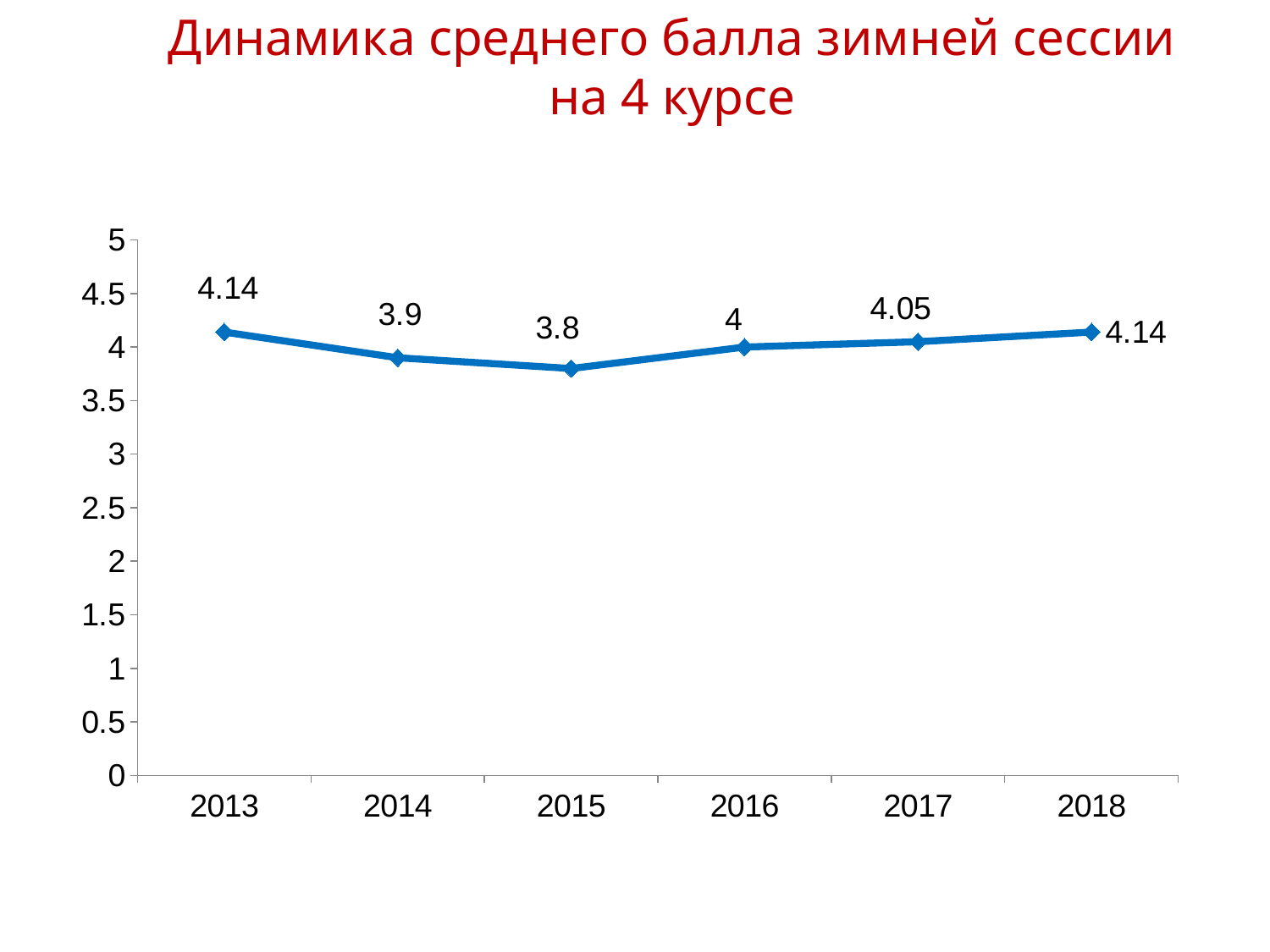
What is the value for 2015? 3.8 Do the values rise or fall from 2015 to 2018? rise Which is larger, the value for 2016 or the value for 2014? 2016 How many years are plotted on the chart? 6 What is the difference between the values for 2013 and 2015? 0.34 What is the difference between the values for 2017 and 2016? 0.05 Is the value for 2016 greater or less than 3.5? greater What is the value for 2014? 3.9 What is the title of the chart? Динамика среднего балла зимней сессии на 4 курсе What kind of chart is shown on the slide? line chart Which year has the lowest value? 2015 What is the value for 2017? 4.05